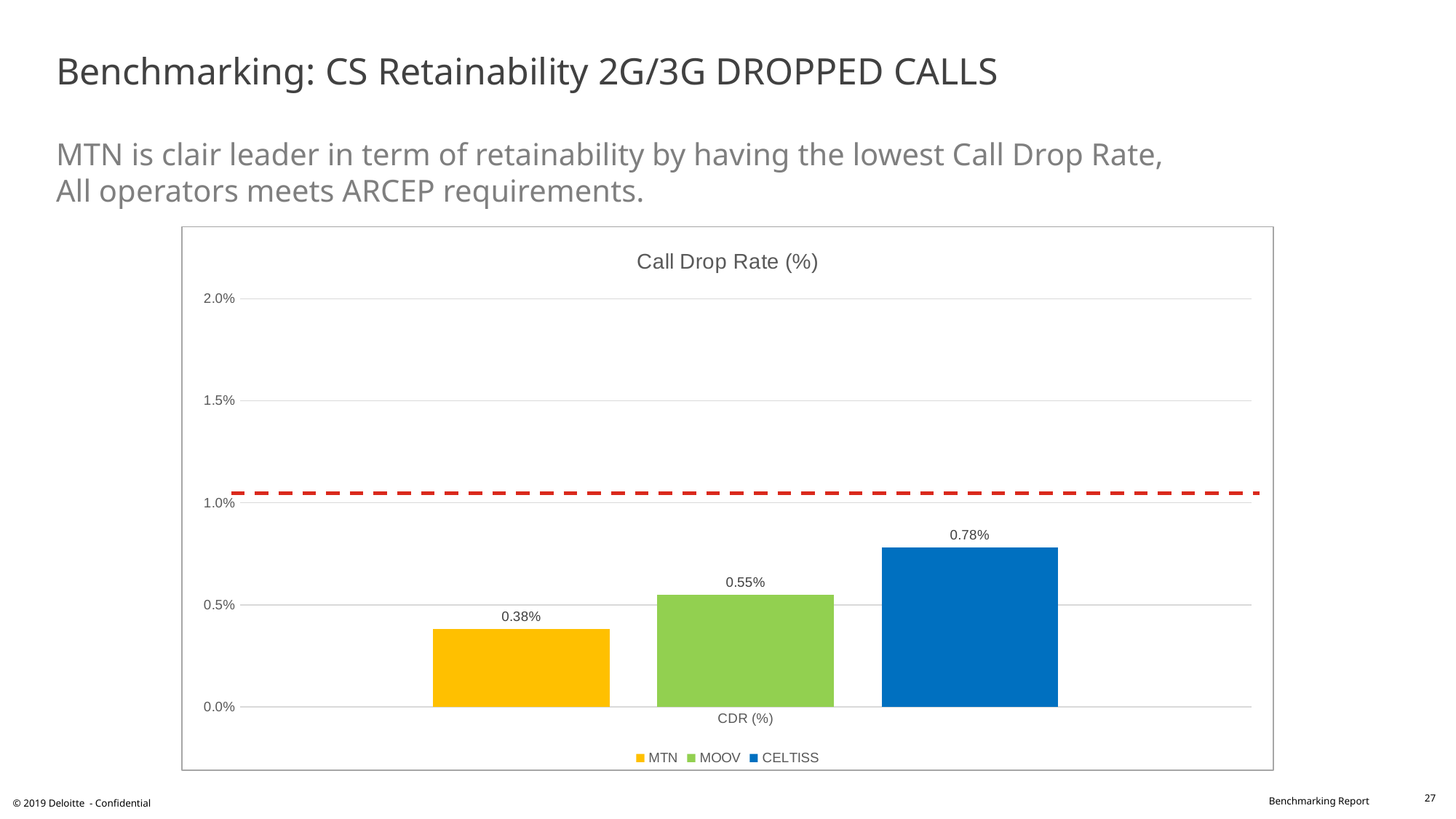
What is the Call Drop Rate for CELTISS? 0.78% Is the Call Drop Rate for CELTISS greater or less than 1.0%? less What is the title of the chart? Call Drop Rate (%) How many series does the legend list? 3 What kind of chart is shown on the slide? Bar chart What is the Call Drop Rate for MOOV? 0.55% What is the difference between the Call Drop Rate of MOOV and MTN? 0.17% Which has a higher Call Drop Rate, MOOV or CELTISS? CELTISS Which operator has the lowest Call Drop Rate? MTN Which operator has the highest Call Drop Rate? CELTISS What is the difference between the Call Drop Rate of CELTISS and MTN? 0.40% What is the Call Drop Rate for MTN? 0.38%